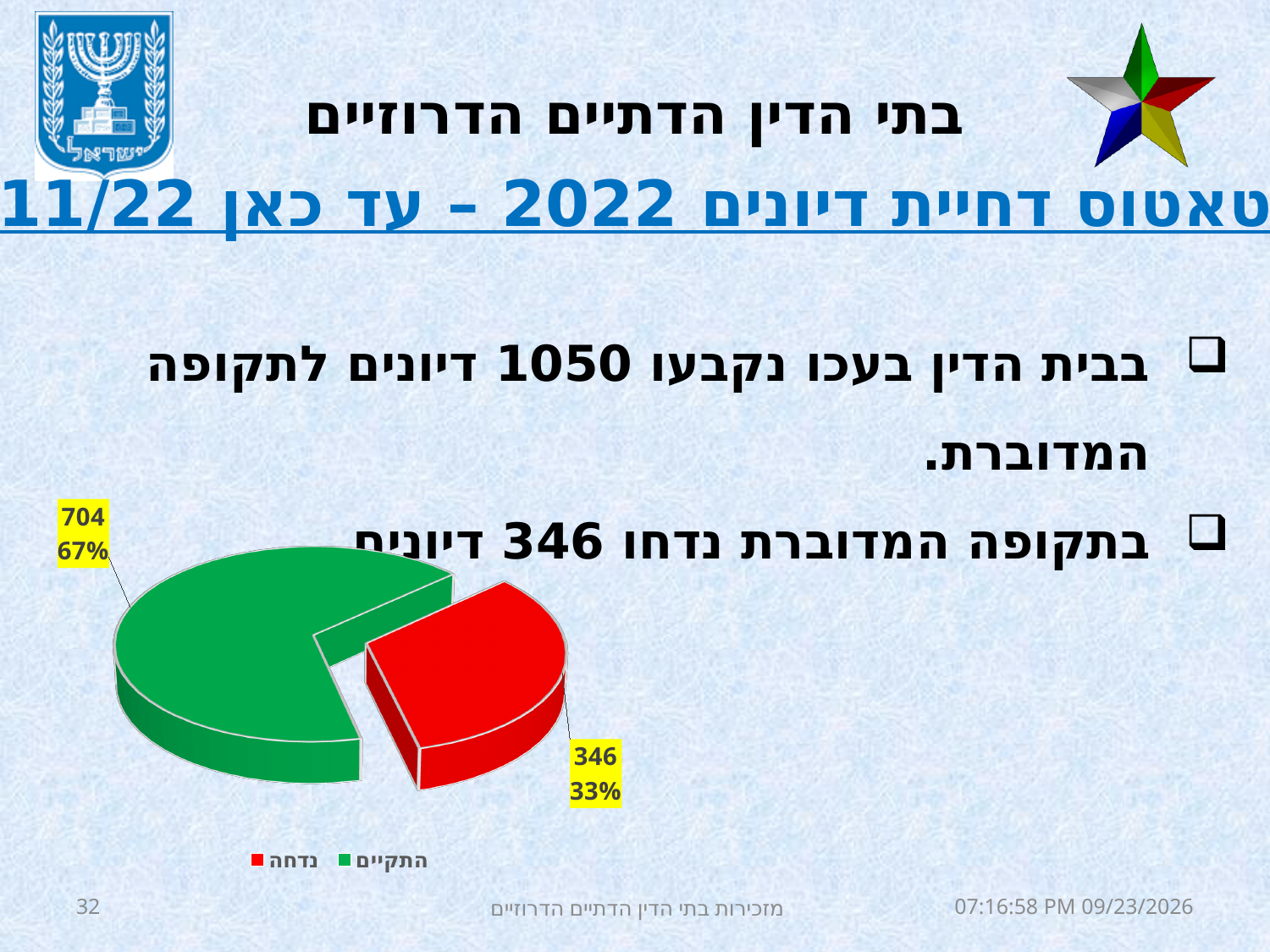
What percentage share does the התקיים slice have in the pie chart? 67% Which is larger in the pie chart, התקיים or נדחה? התקיים What kind of chart is shown on the slide? pie chart How many entries does the legend of the pie chart list? 2 What is the value of the green slice (התקיים) in the pie chart? 704 What percentage share does the נדחה slice have in the pie chart? 33% Which slice of the pie chart is the largest? התקיים What is the difference between the התקיים value and the נדחה value in the pie chart? 358 Which slice of the pie chart is the smallest? נדחה What is the value of the red slice (נדחה) in the pie chart? 346 What colour is the נדחה slice in the pie chart? red How many slices does the pie chart have? 2